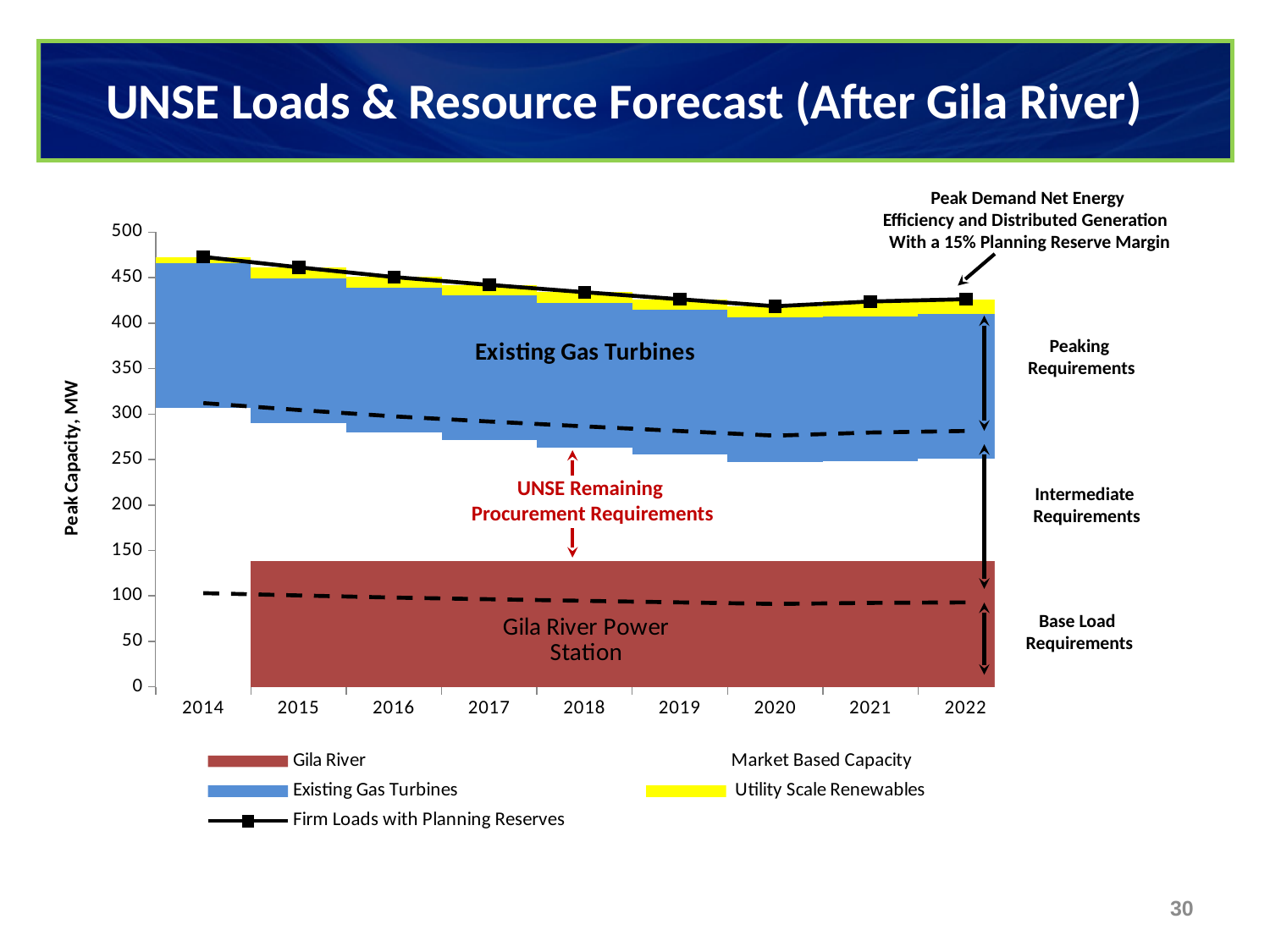
Is the Firm Loads with Planning Reserves value for 2022 greater or less than 400? greater How many years are shown along the x axis? 9 How many series does the legend list? 5 In which year is the Firm Loads with Planning Reserves line at its highest? 2014 What kind of chart is this? Stacked bar chart with a line series What is the label on the vertical axis of the chart? Peak Capacity, MW Is the Firm Loads with Planning Reserves value for 2020 greater or less than 450? less Is the Firm Loads with Planning Reserves value for 2014 greater or less than 450? greater Which is larger, the Firm Loads with Planning Reserves value in 2014 or in 2020? 2014 What is the title of the chart? UNSE Loads & Resource Forecast (After Gila River) Does the Firm Loads with Planning Reserves line rise or fall from 2014 to 2020? fall